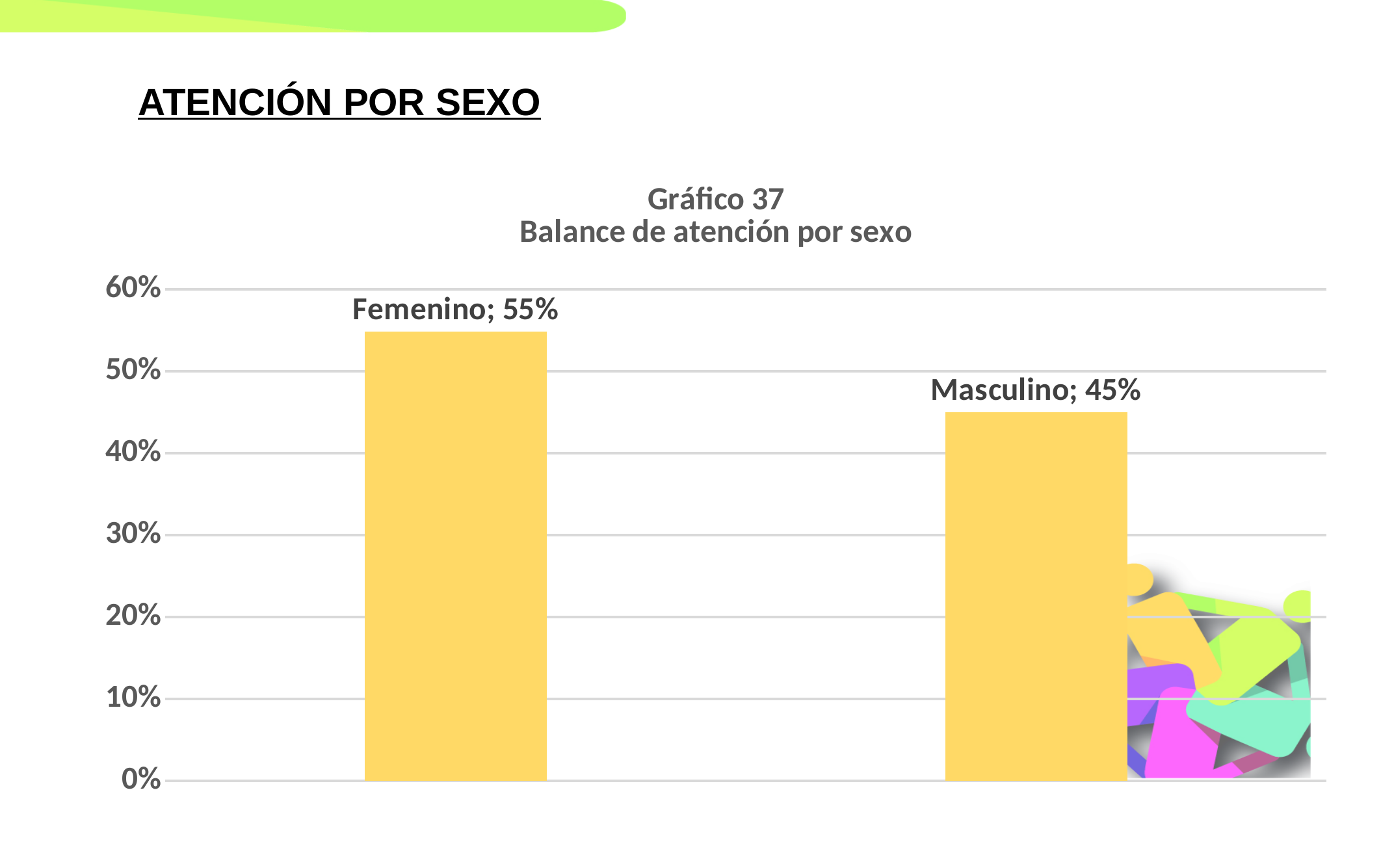
Is the value for Masculino greater or less than 50%? less What is the value for Femenino? 55% What is the highest value shown on the vertical axis? 60% Which is larger, the value for Femenino or the value for Masculino? Femenino Which category has the lowest value? Masculino What is the value for Masculino? 45% Which category has the highest value? Femenino What is the difference between the values for Femenino and Masculino? 10% How many categories are shown in the chart? 2 What is the title of the chart? Gráfico 37 Balance de atención por sexo Is the value for Femenino greater or less than 50%? greater What kind of chart is shown on the slide? bar chart